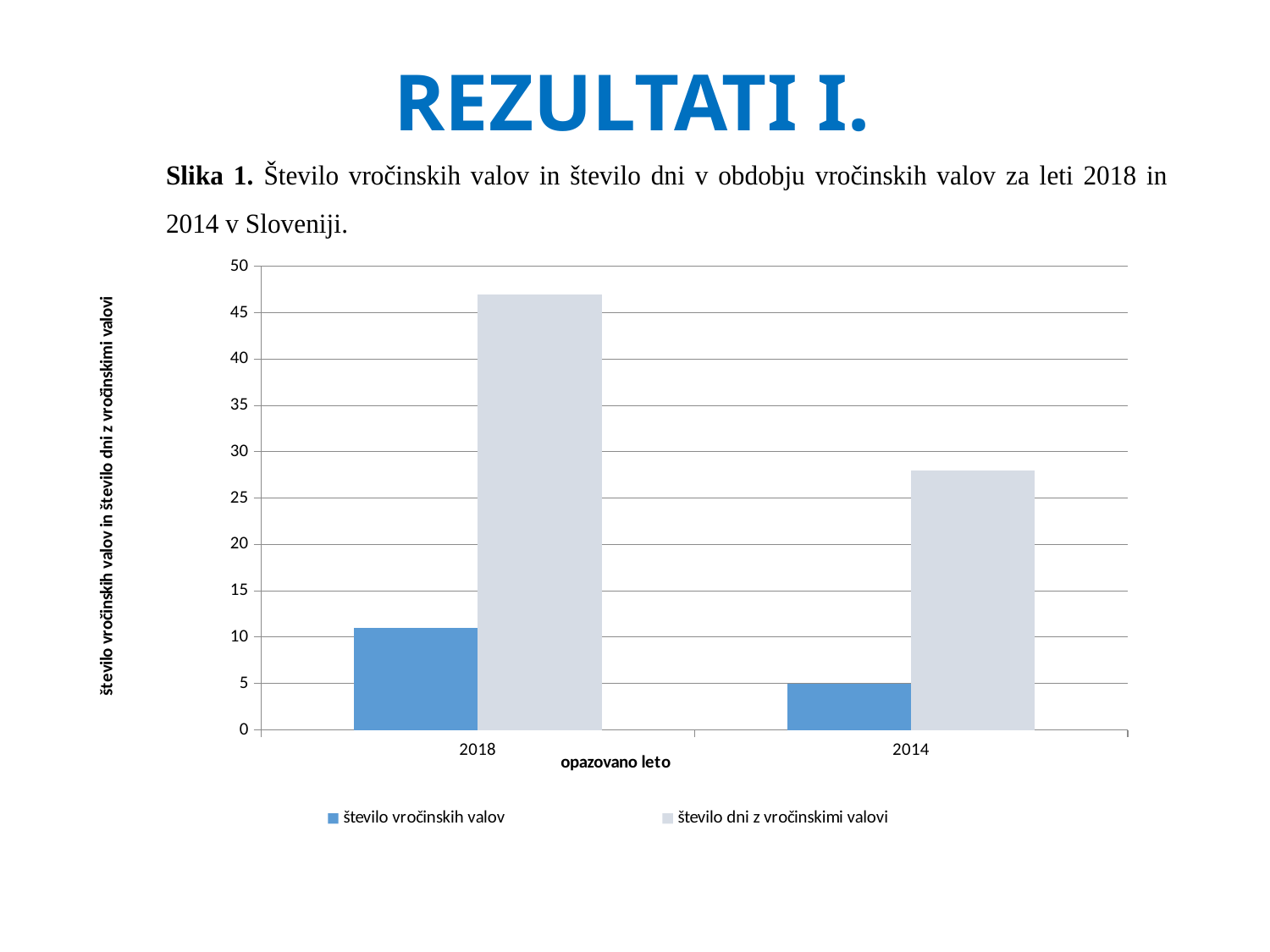
What is the value of 'število vročinskih valov' for 2014? 5 How many years (categories) are shown on the x axis? 2 Do the values of 'število dni z vročinskimi valovi' rise or fall from left to right along the x axis? fall How many series does the legend list? 2 Which year has the larger value for 'število dni z vročinskimi valovi', 2018 or 2014? 2018 Is the value of 'število dni z vročinskimi valovi' for 2014 greater or less than 30? less What is the title of the x axis? opazovano leto Is the value of 'število vročinskih valov' for 2018 greater or less than 10? greater Is the value of 'število dni z vročinskimi valovi' for 2018 greater or less than 45? greater What kind of chart is shown on the slide? bar chart Which year has the highest value for 'število vročinskih valov'? 2018 What colour are the bars for 'število vročinskih valov'? blue